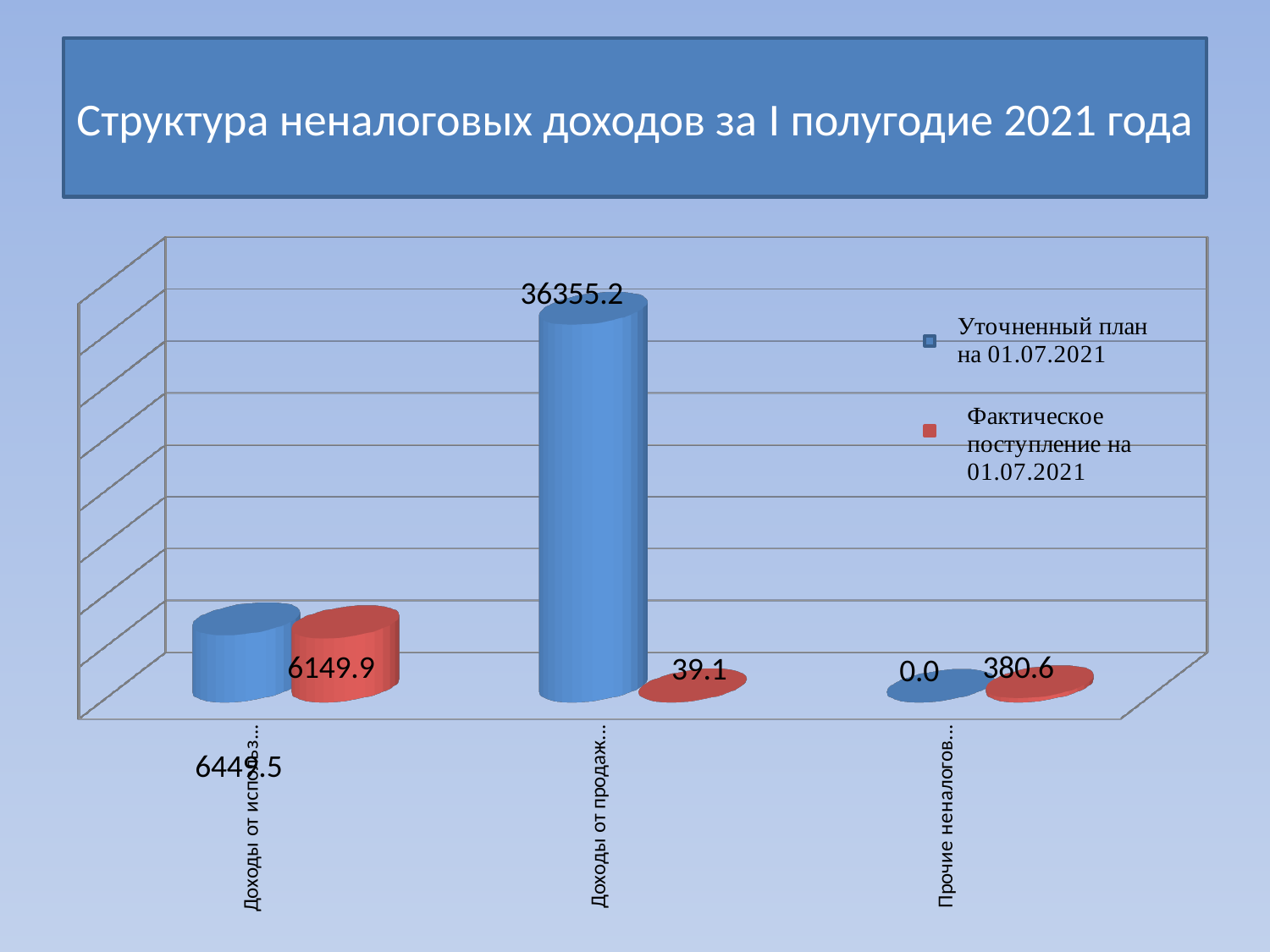
What kind of chart is shown on the slide? bar chart For the middle category ('Доходы от продаж...'), what is the difference between 'Уточненный план на 01.07.2021' and 'Фактическое поступление на 01.07.2021'? 36316.1 How many categories are plotted along the x axis? 3 For the right-hand category ('Прочие неналогов...'), which series has the larger value? Фактическое поступление на 01.07.2021 How many series does the legend list? 2 What is the value of 'Уточненный план на 01.07.2021' for the right-hand category ('Прочие неналогов...')? 0.0 What is the value of 'Фактическое поступление на 01.07.2021' for the middle category ('Доходы от продаж...')? 39.1 What is the value of 'Фактическое поступление на 01.07.2021' for the left-hand category ('Доходы от испо...')? 6149.9 Which category has the lowest value for 'Уточненный план на 01.07.2021'? Прочие неналогов... Which category has the highest value for 'Уточненный план на 01.07.2021'? Доходы от продаж... What is the value of 'Фактическое поступление на 01.07.2021' for the right-hand category ('Прочие неналогов...')? 380.6 What is the value of 'Уточненный план на 01.07.2021' for the middle category ('Доходы от продаж...')? 36355.2